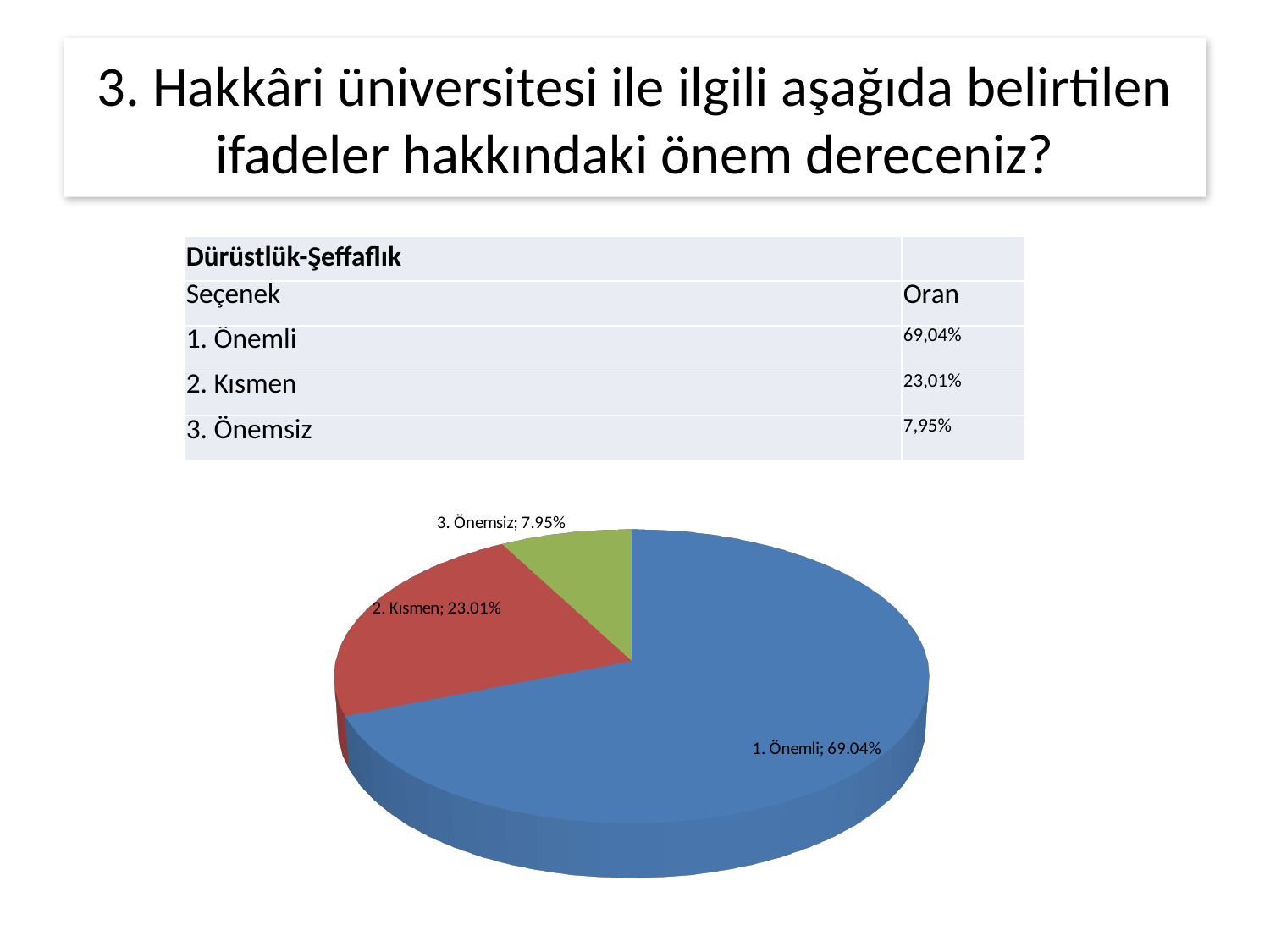
How many slices does the pie chart have? 3 What is the value shown for the "3. Önemsiz" slice in the pie chart? 7.95% What is the difference between the "1. Önemli" and "2. Kısmen" values in the pie chart? 46.03% What colour is the "3. Önemsiz" slice in the pie chart? green What is the difference between the "2. Kısmen" and "3. Önemsiz" values in the pie chart? 15.06% What is the value shown for the "2. Kısmen" slice in the pie chart? 23.01% Which slice of the pie chart is the smallest? 3. Önemsiz What kind of chart is shown on the slide? pie chart Which is larger in the pie chart, "2. Kısmen" or "3. Önemsiz"? 2. Kısmen What is the value shown for the "1. Önemli" slice in the pie chart? 69.04% Which slice of the pie chart is the largest? 1. Önemli What colour is the "1. Önemli" slice in the pie chart? blue